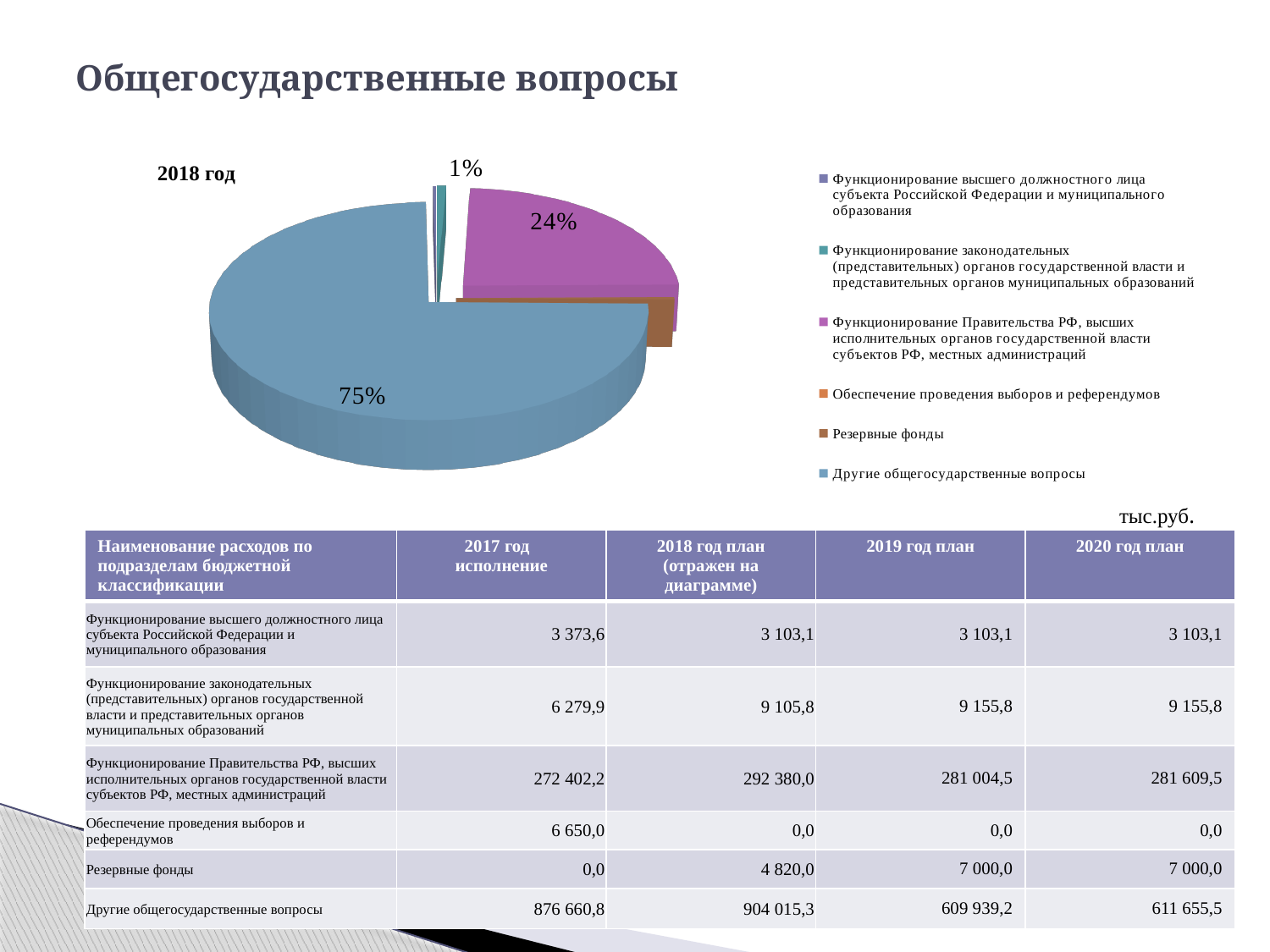
How many percentage labels are printed on the pie chart? 3 How many categories does the legend of the pie chart list? 6 By how many percentage points does the 'Другие общегосударственные вопросы' share exceed the 'Функционирование Правительства РФ...' share? 51 percentage points What kind of chart is shown on the slide? pie chart What year does the pie chart's title refer to? 2018 год What share of the pie does 'Функционирование Правительства РФ, высших исполнительных органов государственной власти субъектов РФ, местных администраций' take? 24% Which slice is larger: 'Функционирование Правительства РФ...' or 'Другие общегосударственные вопросы'? Другие общегосударственные вопросы What colour is the largest slice of the pie chart? blue What is the smallest percentage label printed on the pie chart? 1% Which category has the largest slice of the pie? Другие общегосударственные вопросы Is the share of 'Другие общегосударственные вопросы' greater or less than 50%? greater What share of the pie does 'Другие общегосударственные вопросы' take? 75%